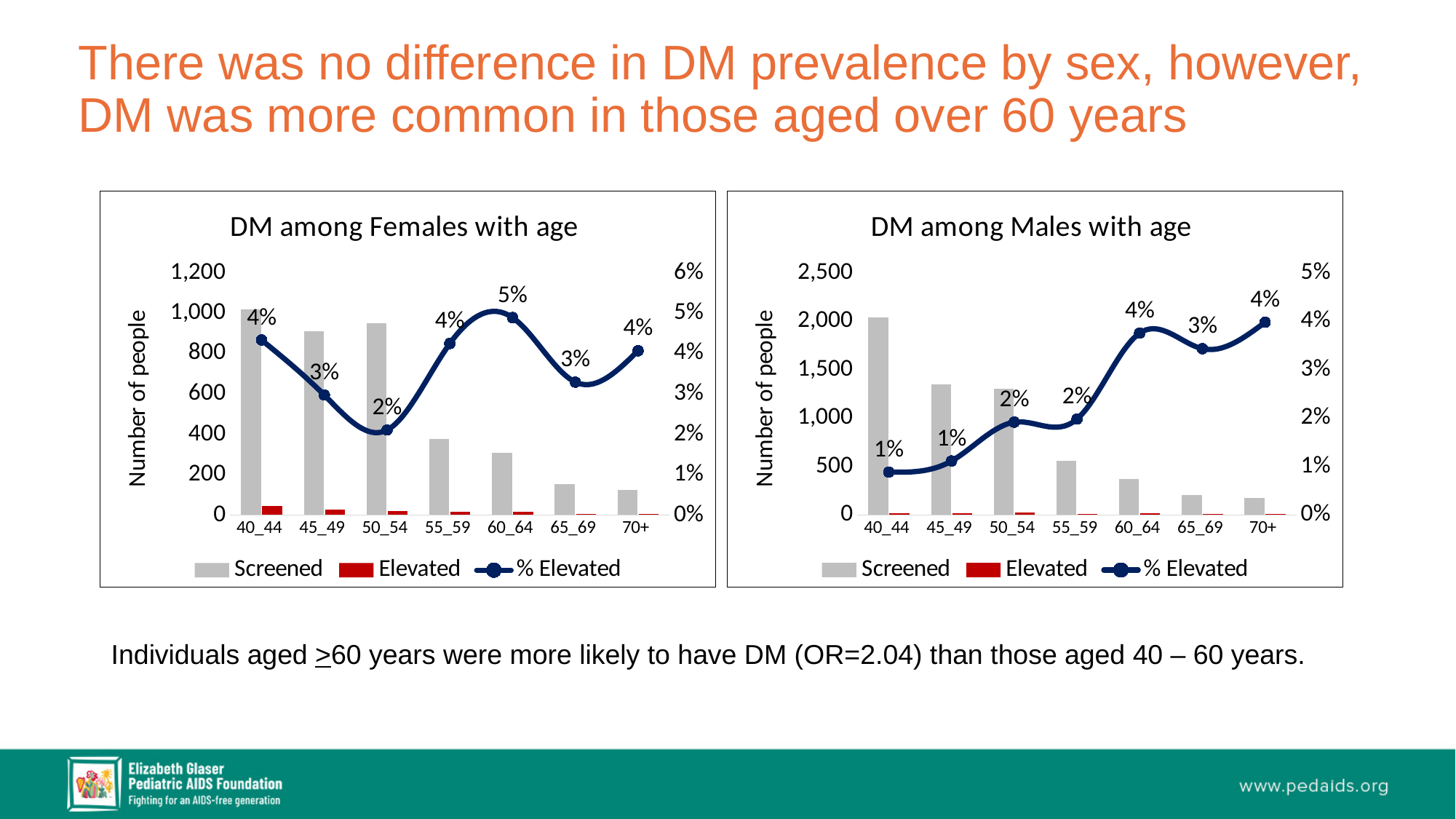
In the 'DM among Females with age' chart, what is the % Elevated value for the 60_64 age group? 5% In the 'DM among Females with age' chart, which age group has the highest % Elevated? 60_64 In the 'DM among Females with age' chart, what is the difference in % Elevated between the 60_64 and 50_54 age groups? 3% In the 'DM among Males with age' chart, does the % Elevated line generally rise or fall as age increases? rise In the 'DM among Males with age' chart, is the number of people screened in the 40_44 age group greater or less than 1,500? greater In the 'DM among Females with age' chart, is the number of people screened in the 70+ age group greater or less than 200? less How many series does the legend of the 'DM among Females with age' chart list? 3 In the 'DM among Males with age' chart, which has a higher % Elevated: the 60_64 age group or the 45_49 age group? 60_64 How many age groups are shown on the x axis of the 'DM among Males with age' chart? 7 In the 'DM among Males with age' chart, what is the % Elevated value for the 40_44 age group? 1% What kind of chart is 'DM among Males with age'? Combined bar and line chart In the 'DM among Females with age' chart, which age group has the lowest % Elevated? 50_54